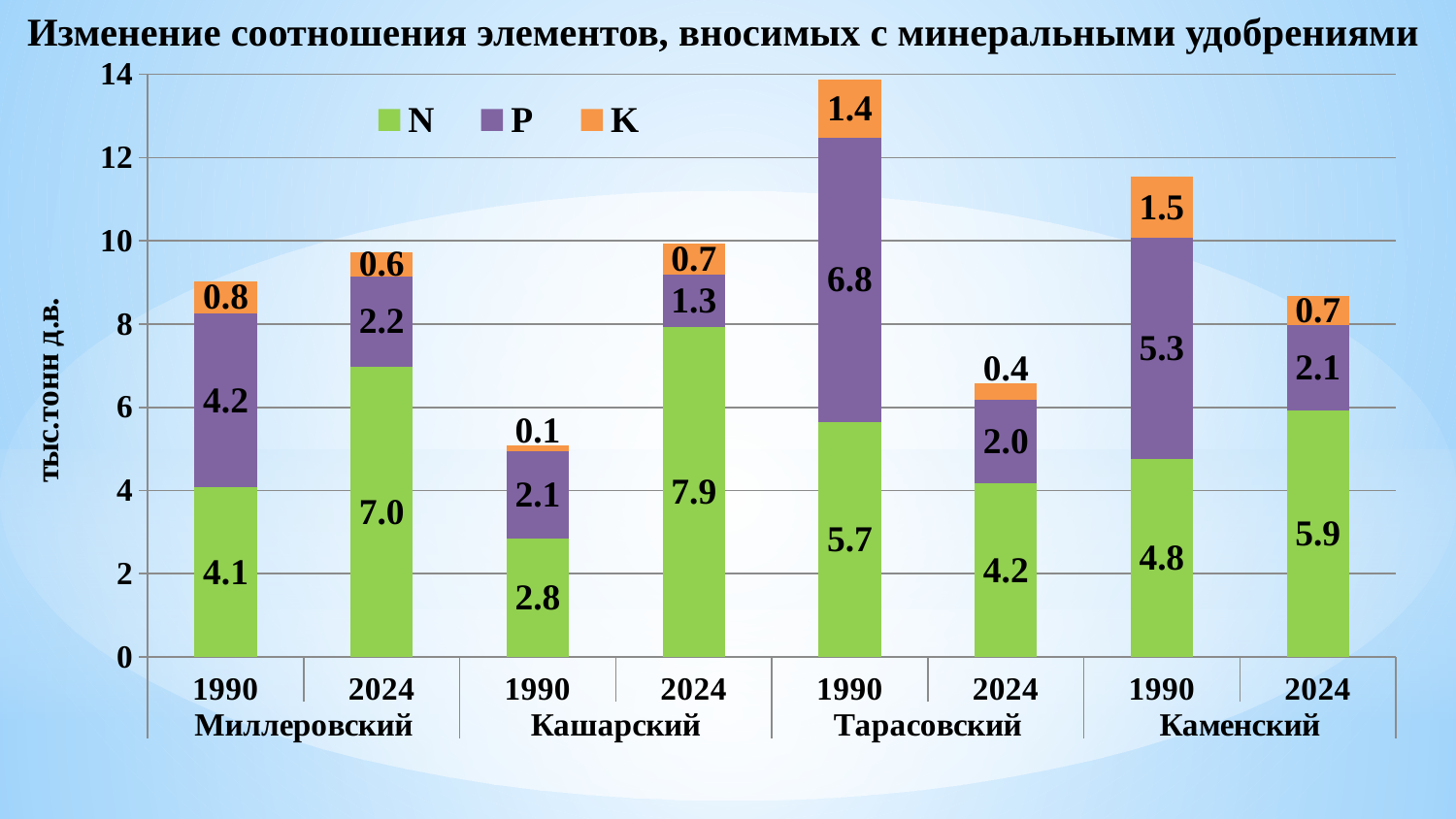
Which is larger: the P value for Каменский in 1990 or the P value for Каменский in 2024? Каменский 1990 What is the total of the stacked bar for Миллеровский in 1990? 9.1 How many series does the legend list? 3 What is the difference between the N values for Миллеровский in 2024 and 1990? 2.9 What is the value of N for Кашарский in 2024? 7.9 Which bar has the highest value of P? Тарасовский 1990 What is the value of P for Тарасовский in 1990? 6.8 What is the value of K for Каменский in 1990? 1.5 What type of chart is shown on the slide? stacked bar chart Which bar has the lowest value of K? Кашарский 1990 How many bars are plotted in the chart? 8 What is the label of the vertical axis? тыс.тонн д.в.